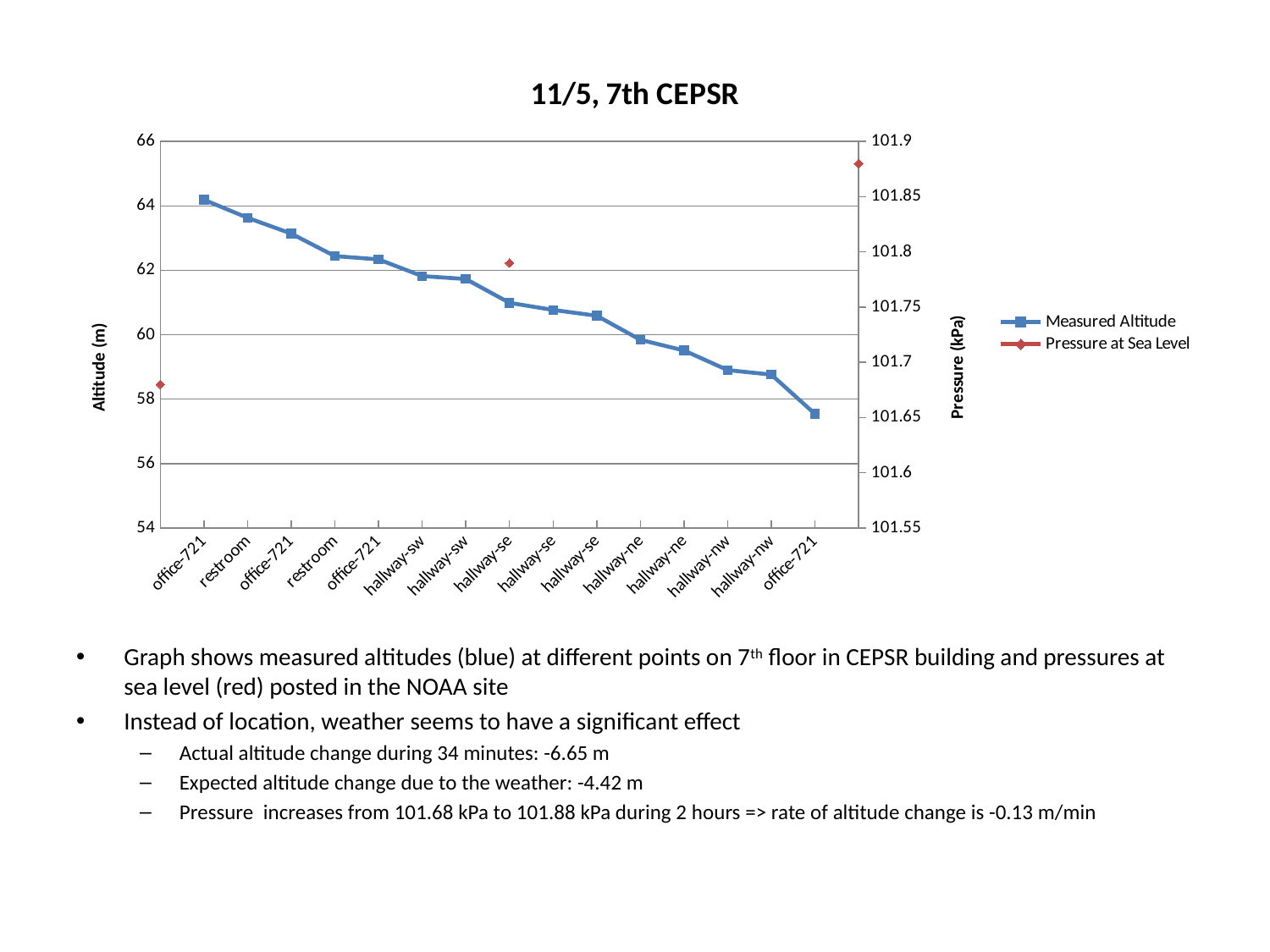
Is the Measured Altitude at the first restroom point greater or less than 62? greater Which point has the highest Measured Altitude? the leftmost office-721 point What type of chart is shown on the slide? line chart What is the title of the chart? 11/5, 7th CEPSR How many series does the chart legend list? 2 What are the two series named in the legend? Measured Altitude and Pressure at Sea Level Does the Measured Altitude series rise or fall from left to right along the x axis? fall Which point has the lowest Measured Altitude? the rightmost office-721 point Which has the higher Measured Altitude, the first restroom point or the second restroom point? the first restroom point How many Pressure at Sea Level points are plotted on the chart? 3 Is the Measured Altitude at the rightmost office-721 point greater or less than 58? less How many location labels are shown along the x axis? 15